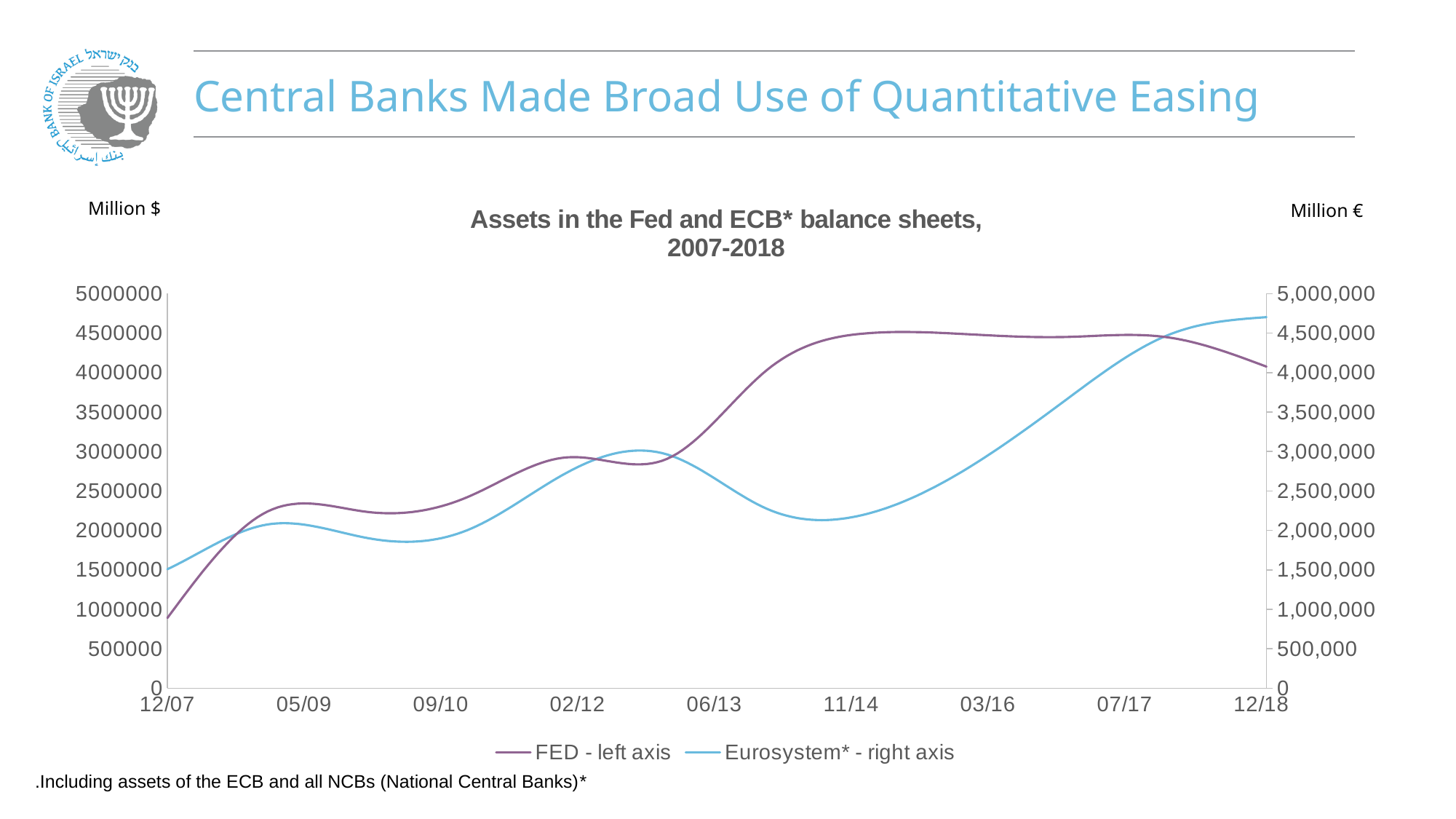
Is the value for FED at 12/07 greater or less than 1000000? less At 11/14, which line is plotted higher on the chart, FED or Eurosystem? FED Which series is plotted against the right axis according to the legend? Eurosystem* - right axis Is the value for FED at 05/09 greater or less than 2000000? greater Is the value for Eurosystem at 12/18 greater or less than 4,500,000? greater What is the title of the chart? Assets in the Fed and ECB* balance sheets, 2007-2018 How many date labels are shown on the x axis? 9 What kind of chart is shown on the slide? Line chart Does the Eurosystem line rise or fall between 11/14 and 12/18? Rises How many series does the legend list? 2